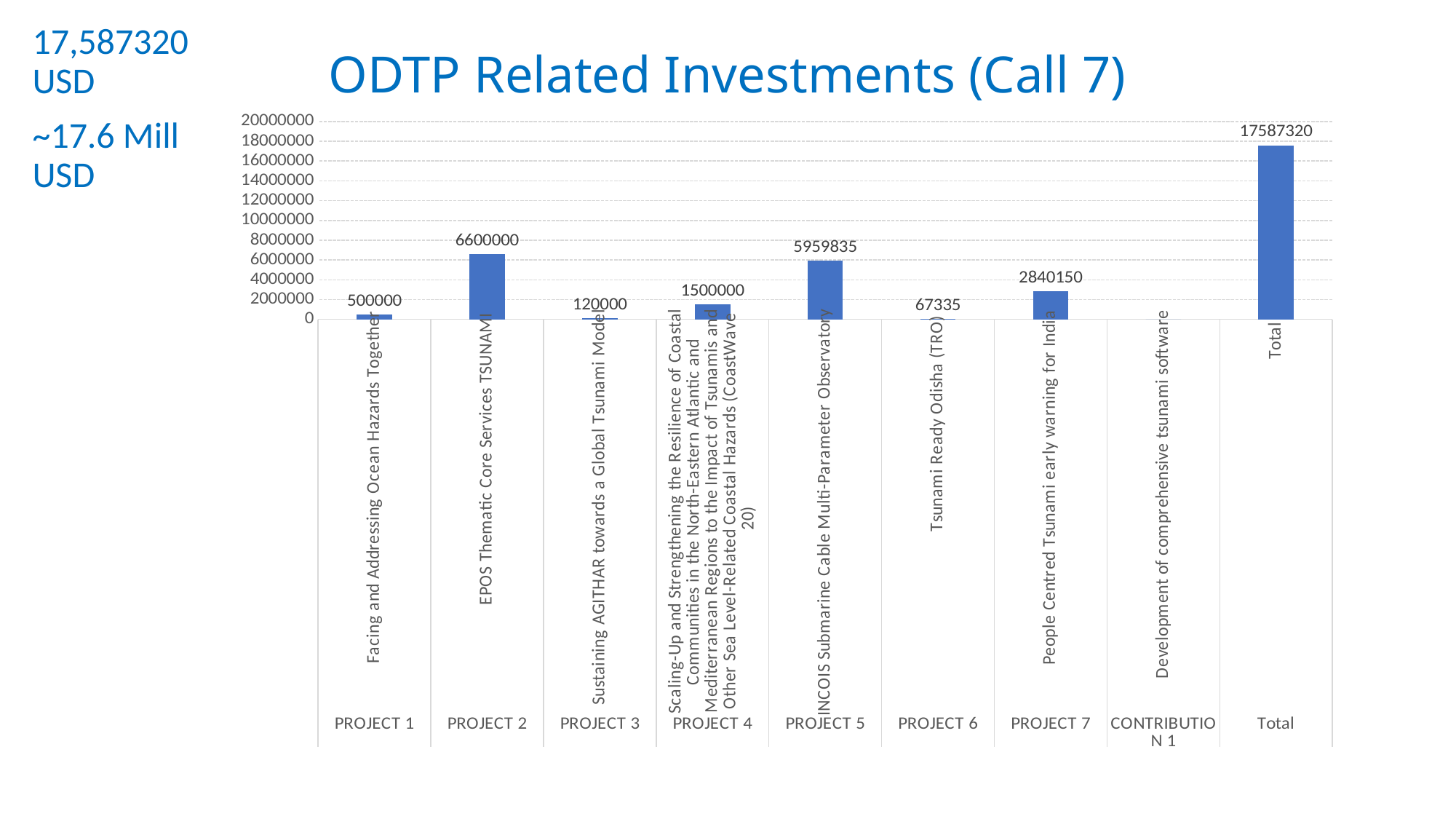
Among the labelled projects, which has the lowest investment? PROJECT 6 What is the value for PROJECT 2 (EPOS Thematic Core Services TSUNAMI)? 6600000 What is the title of the chart? ODTP Related Investments (Call 7) Excluding the Total bar, which project has the highest investment? PROJECT 2 What kind of chart is shown on the slide? bar chart What is the value shown for the Total bar? 17587320 What is the value for PROJECT 7 (People Centred Tsunami early warning for India)? 2840150 Which is larger, the value for PROJECT 4 or the value for PROJECT 7? PROJECT 7 What is the difference between the values for PROJECT 2 and PROJECT 5? 640165 Is the value for PROJECT 2 greater or less than 6000000? greater What is the value for PROJECT 5 (INCOIS Submarine Cable Multi-Parameter Observatory)? 5959835 How many categories are shown on the x axis of the chart? 9